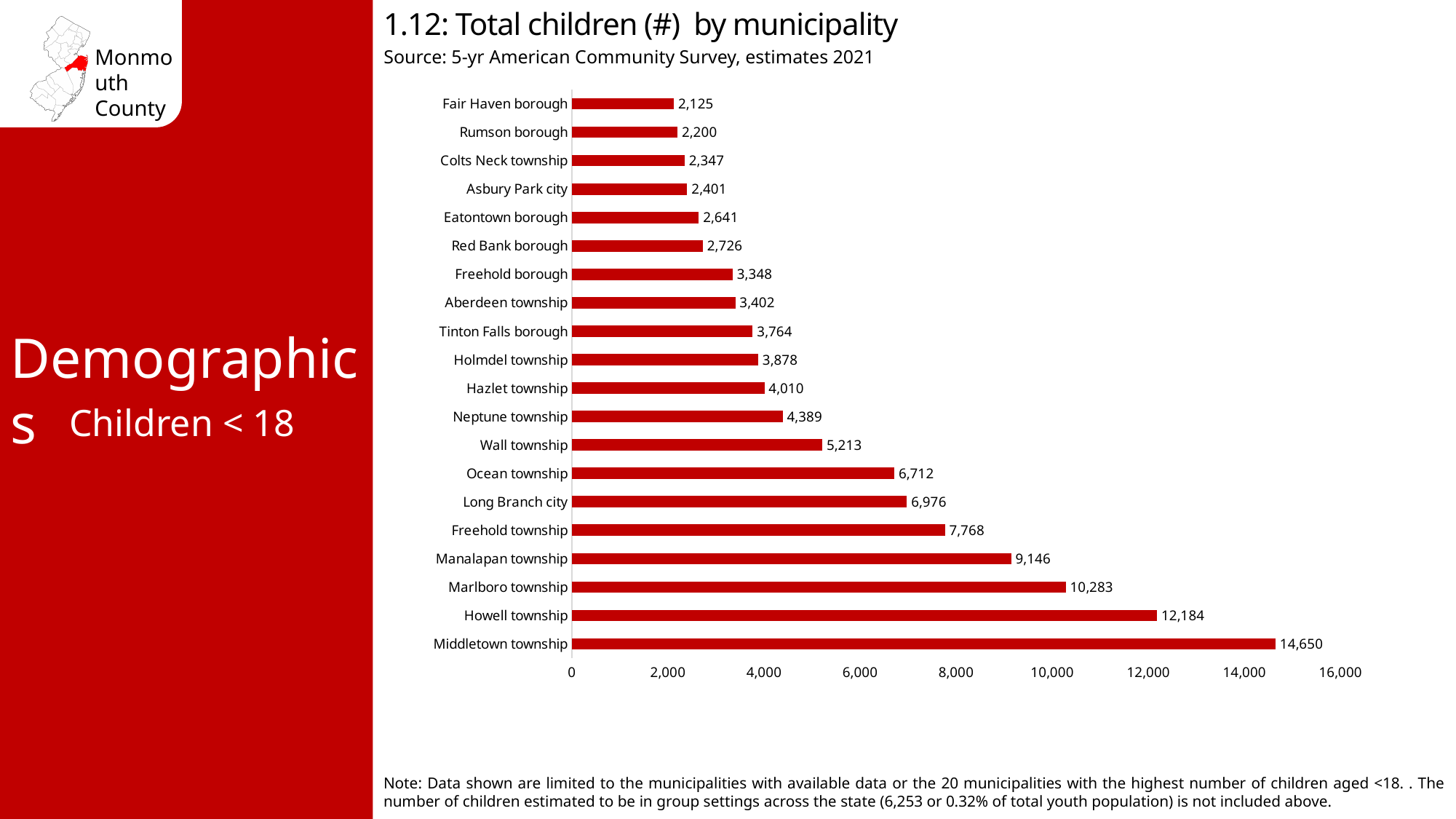
Is the value for Freehold township greater or less than 8,000? less What is the total number of children in Wall township? 5,213 Which municipality has the highest number of children? Middletown township How many municipalities are shown in the chart? 20 What is the source of the data shown in the chart? 5-yr American Community Survey, estimates 2021 Which municipality has the lowest number of children? Fair Haven borough What kind of chart is used to show total children by municipality? bar chart What is the difference in the number of children between Marlboro township and Manalapan township? 1,137 What is the total number of children in Middletown township? 14,650 Which has more children, Ocean township or Long Branch city? Long Branch city What is the difference in the number of children between Middletown township and Howell township? 2,466 What is the total number of children in Asbury Park city? 2,401